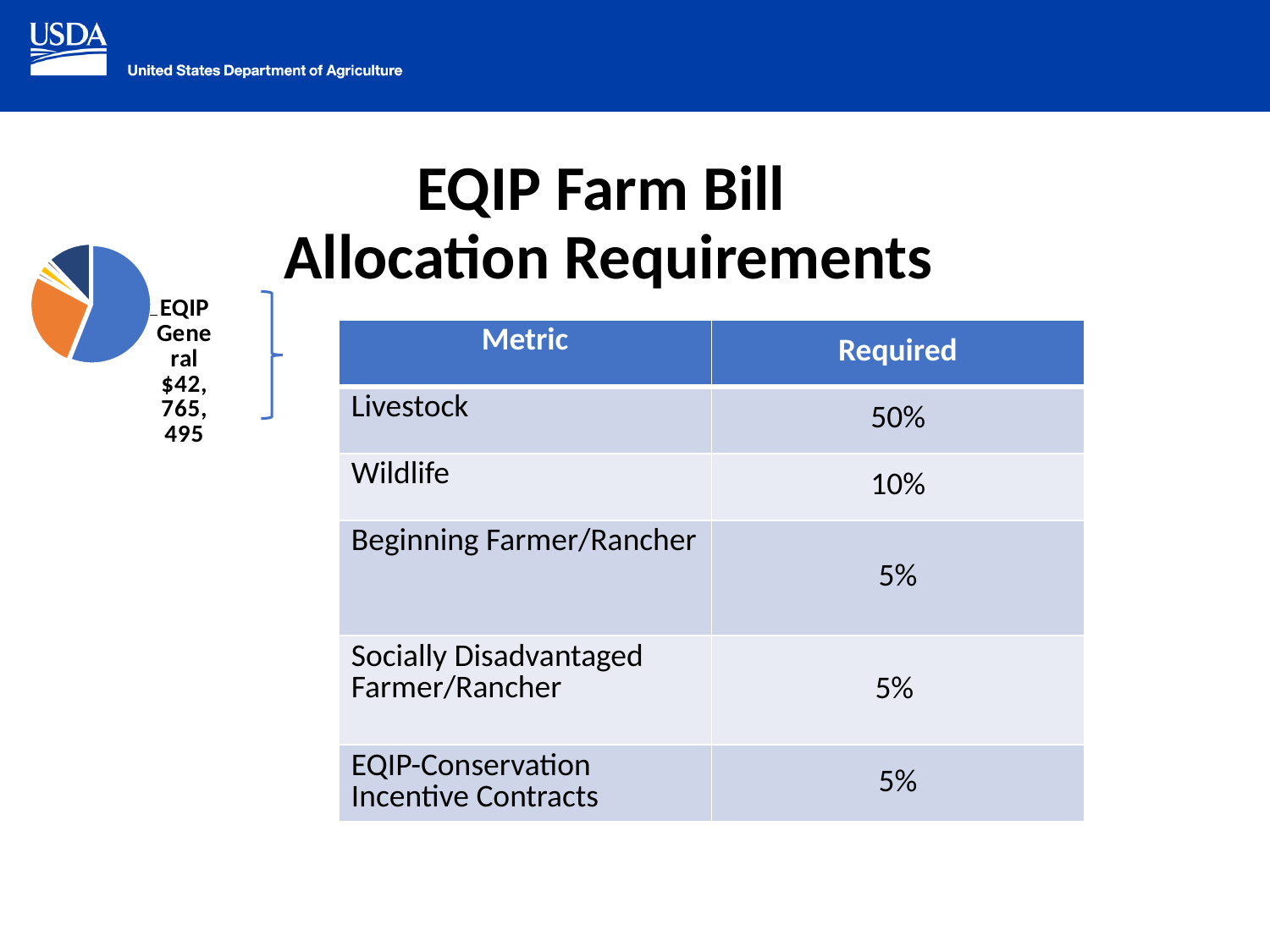
In the pie chart, what value is shown for EQIP General? $42,765,495 In the pie chart, what colour is the EQIP General slice? blue In the pie chart, does the EQIP General slice take up more or less than half of the pie? more What kind of chart is shown on the left of the slide? pie chart In the pie chart, which labeled slice is the largest? EQIP General